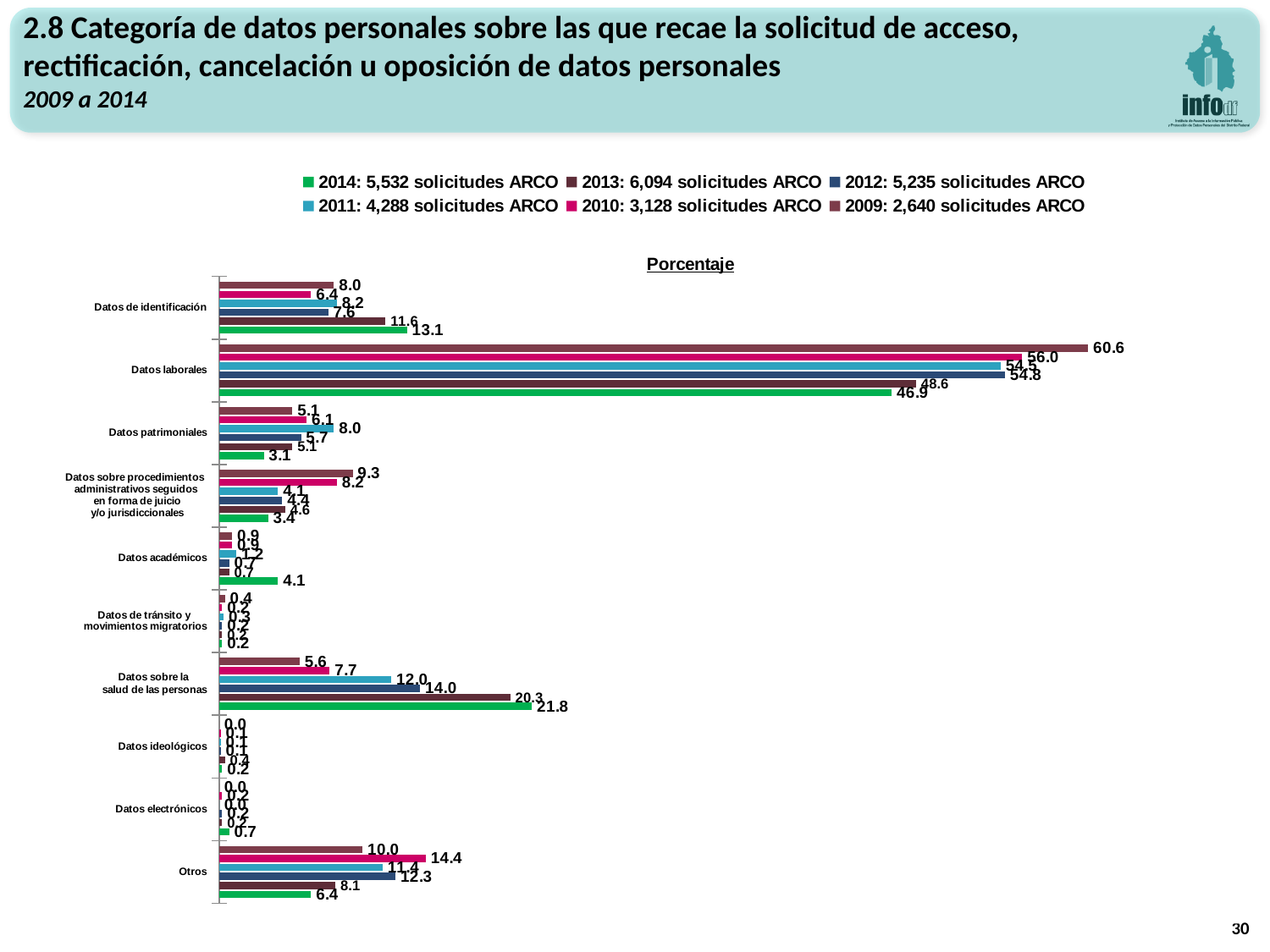
What is the value for Datos laborales in the 2014 series? 46.9 What kind of chart is shown on the slide? bar chart According to the legend, how many solicitudes ARCO were there in 2013? 6,094 What is the value for Datos sobre la salud de las personas in the 2014 series? 21.8 What is the value for Otros in the 2010 series? 14.4 Do the values for Datos sobre la salud de las personas rise or fall from 2009 to 2014? rise How many series does the legend list? 6 What is the difference between the 2009 and 2014 values for Datos laborales? 13.7 Which category has the highest value in the 2014 series? Datos laborales For Datos de identificación, which is larger: the 2014 value or the 2013 value? 2014 What is the value for Datos laborales in the 2009 series? 60.6 How many categories are shown on the chart? 10